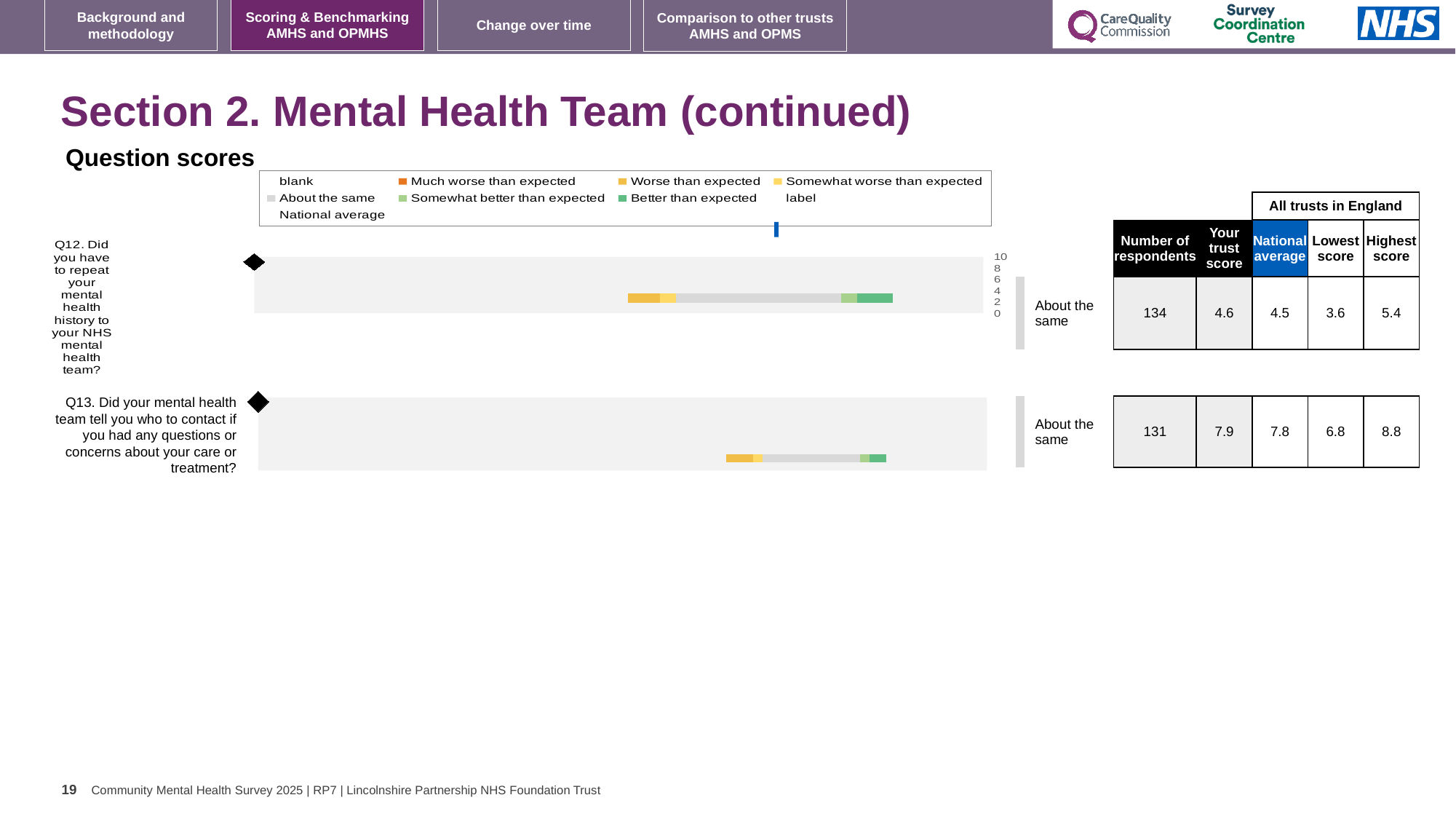
For Q12, which is larger: the trust score or the national average? the trust score What kind of chart is used to show the question scores for Q12 and Q13? bar chart What benchmark category is shown next to the Q12 chart? About the same What is the trust score for Q12 (repeating your mental health history)? 4.6 Which question has the higher trust score, Q12 or Q13? Q13 How many questions are charted on the slide? 2 What is the trust score for Q13 (who to contact with questions or concerns)? 7.9 How many respondents are shown for Q13? 131 What is the highest score among all trusts in England for Q13? 8.8 How many respondents are shown for Q12 (repeating your mental health history)? 134 What is the difference between the highest score and the lowest score for Q13? 2.0 What is the national average for Q12 (repeating your mental health history)? 4.5